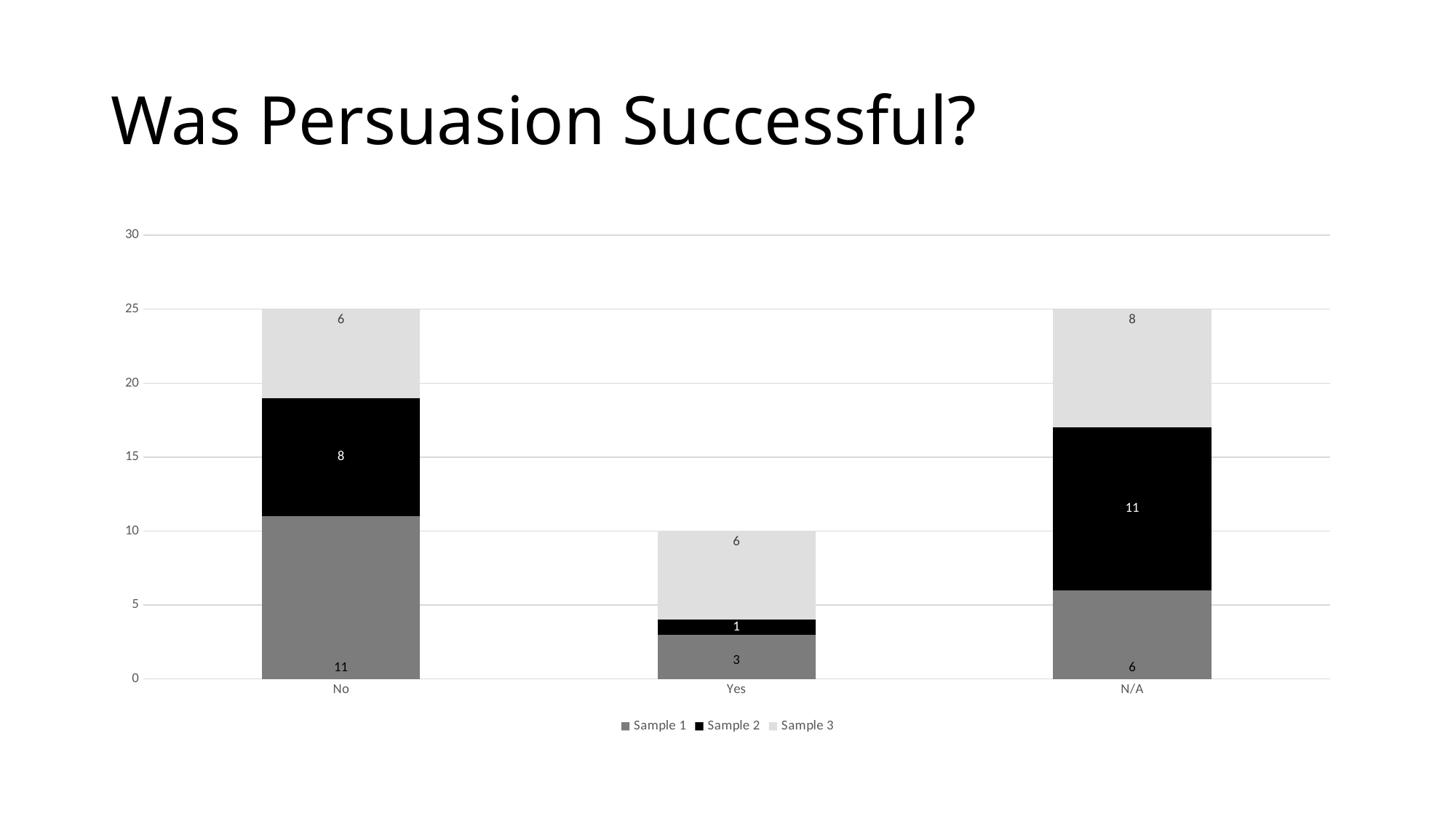
What is the total of the stacked bar for the No category? 25 What is the Sample 2 value for the N/A category? 11 What is the Sample 3 value for the N/A category? 8 What kind of chart is shown on the slide? Stacked bar chart Which category has the highest Sample 2 value? N/A How many series does the legend list? 3 What is the difference between the Sample 2 values for N/A and No? 3 Which is larger, the Sample 1 value for No or the Sample 1 value for N/A? No What is the Sample 1 value for the No category? 11 Which category has the lowest Sample 1 value? Yes What is the total of the stacked bar for the Yes category? 10 What is the Sample 2 value for the Yes category? 1